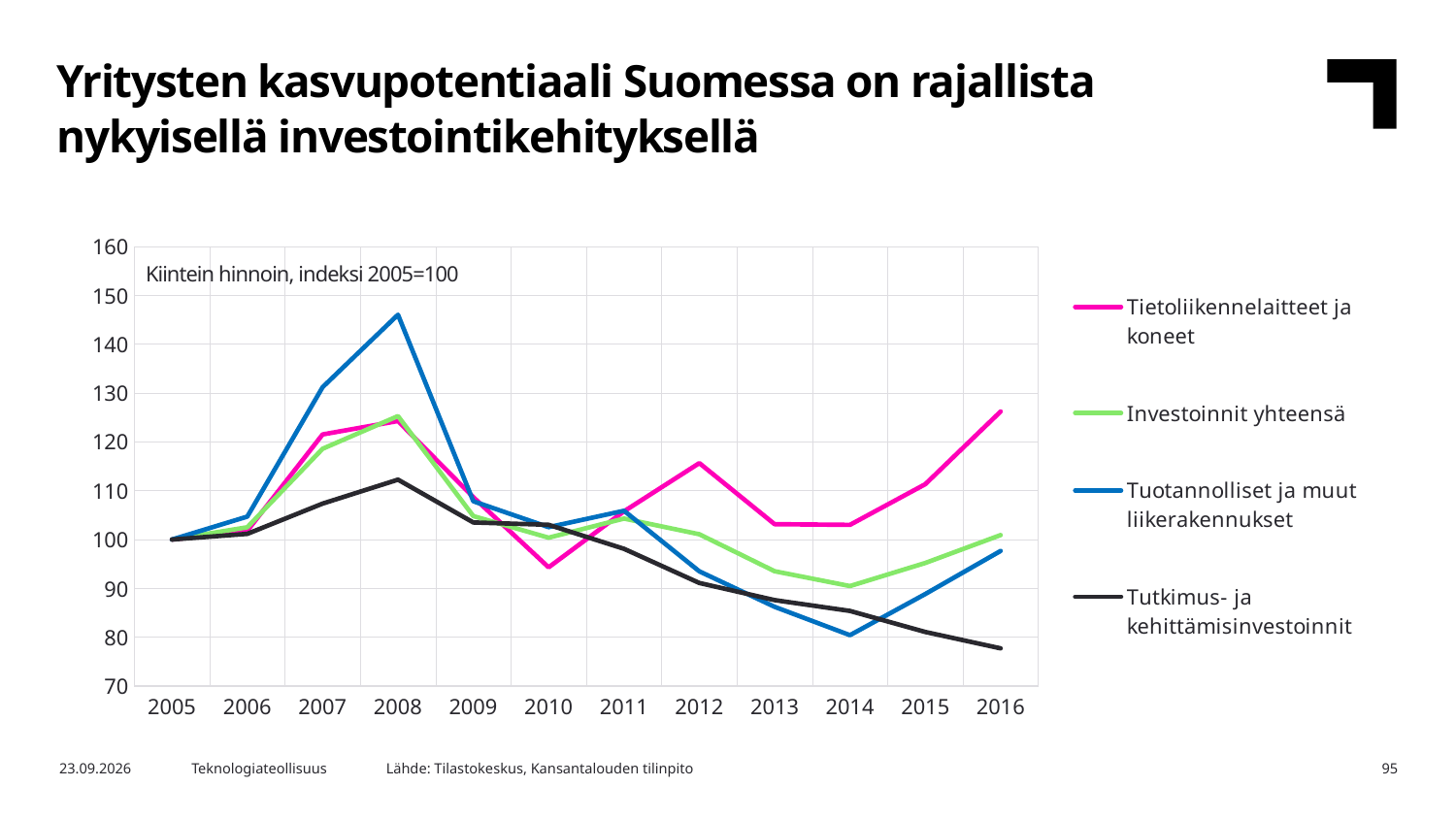
In 2014, which is higher: Tietoliikennelaitteet ja koneet or Tuotannolliset ja muut liikerakennukset? Tietoliikennelaitteet ja koneet According to the note in the chart, which year is the index base year (=100)? 2005 What is the index value of all series in 2005? 100 How many series does the legend list? 4 Is the value for Tietoliikennelaitteet ja koneet in 2016 greater or less than 120? greater Which series has the lowest value in 2016? Tutkimus- ja kehittämisinvestoinnit How many years are shown on the x axis? 12 Does the Tutkimus- ja kehittämisinvestoinnit series rise or fall from 2008 to 2016? Fall What kind of chart is shown on the slide? Line chart Is the value for Tutkimus- ja kehittämisinvestoinnit in 2016 greater or less than 90? less Which series has the highest value in 2008? Tuotannolliset ja muut liikerakennukset Is the value for Tuotannolliset ja muut liikerakennukset in 2008 greater or less than 140? greater